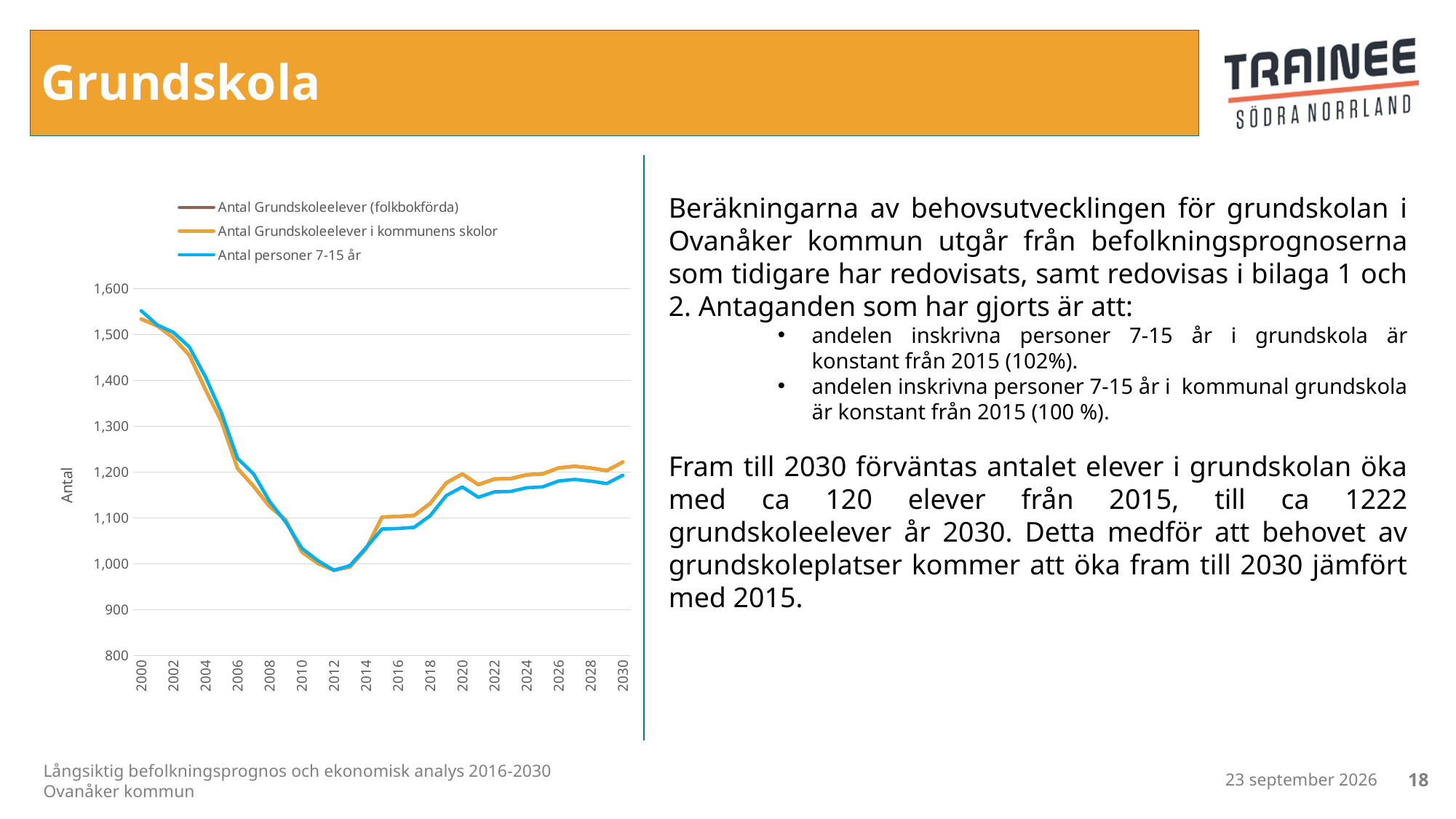
Is the value for 'Antal Grundskoleelever i kommunens skolor' in 2030 greater or less than 1,200? greater What is the label on the vertical axis of the chart? Antal Is the value for 'Antal personer 7-15 år' in 2000 greater or less than 1,500? greater Do the values of 'Antal Grundskoleelever i kommunens skolor' rise or fall between 2012 and 2030? rise Do the values of 'Antal personer 7-15 år' rise or fall between 2000 and 2012? fall Which series is drawn in blue in the chart? Antal personer 7-15 år In 2030, which series has the higher value: 'Antal Grundskoleelever i kommunens skolor' or 'Antal personer 7-15 år'? Antal Grundskoleelever i kommunens skolor In which year does the 'Antal personer 7-15 år' series reach its highest value? 2000 How many year labels are shown on the x axis of the chart? 16 What kind of chart is shown on the slide? line chart How many series does the chart legend list? 3 In which year does the 'Antal personer 7-15 år' series reach its lowest value? 2012